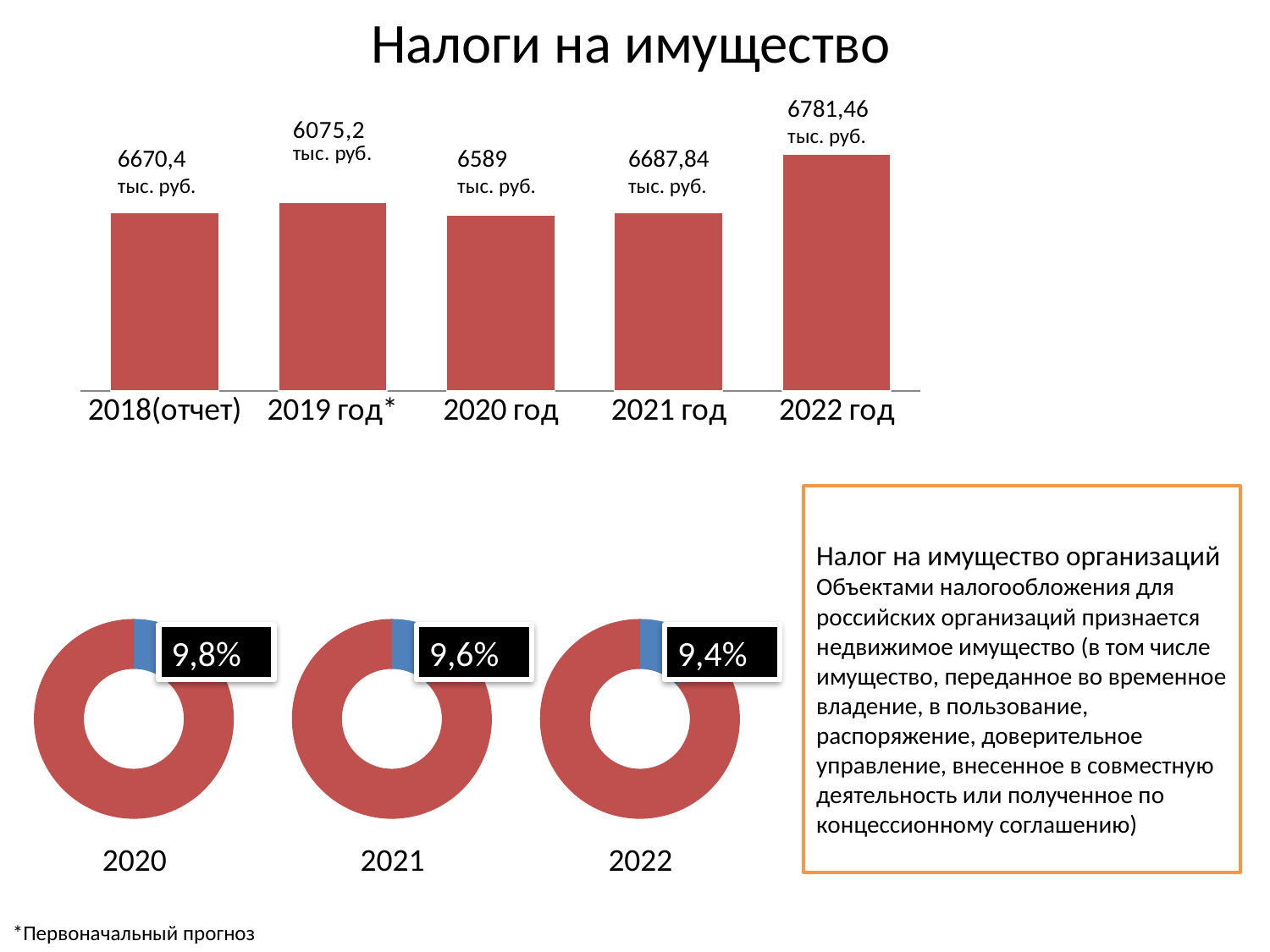
How many bars are shown on the bar chart 'Налоги на имущество'? 5 On the bar chart 'Налоги на имущество', which year has the highest value? 2022 год On the bar chart 'Налоги на имущество', what is the difference between the values for 2018(отчет) and 2020 год? 81,4 тыс. руб. Comparing the donut charts at the bottom of the slide, which year has the larger blue share: 2020 or 2021? 2020 On the bar chart 'Налоги на имущество', what is the value for 2018(отчет)? 6670,4 тыс. руб. On the donut chart labelled 2020 at the bottom of the slide, what share is shown by the blue slice? 9,8% What type of chart is the top chart 'Налоги на имущество'? Bar chart On the bar chart 'Налоги на имущество', what is the difference between the values for 2022 год and 2021 год? 93,62 тыс. руб. On the donut chart labelled 2022 at the bottom of the slide, what share is shown by the blue slice? 9,4% On the bar chart 'Налоги на имущество', what is the value for 2020 год? 6589 тыс. руб. On the bar chart 'Налоги на имущество', which is larger: the value for 2021 год or the value for 2020 год? 2021 год On the bar chart 'Налоги на имущество', what is the value for 2022 год? 6781,46 тыс. руб.